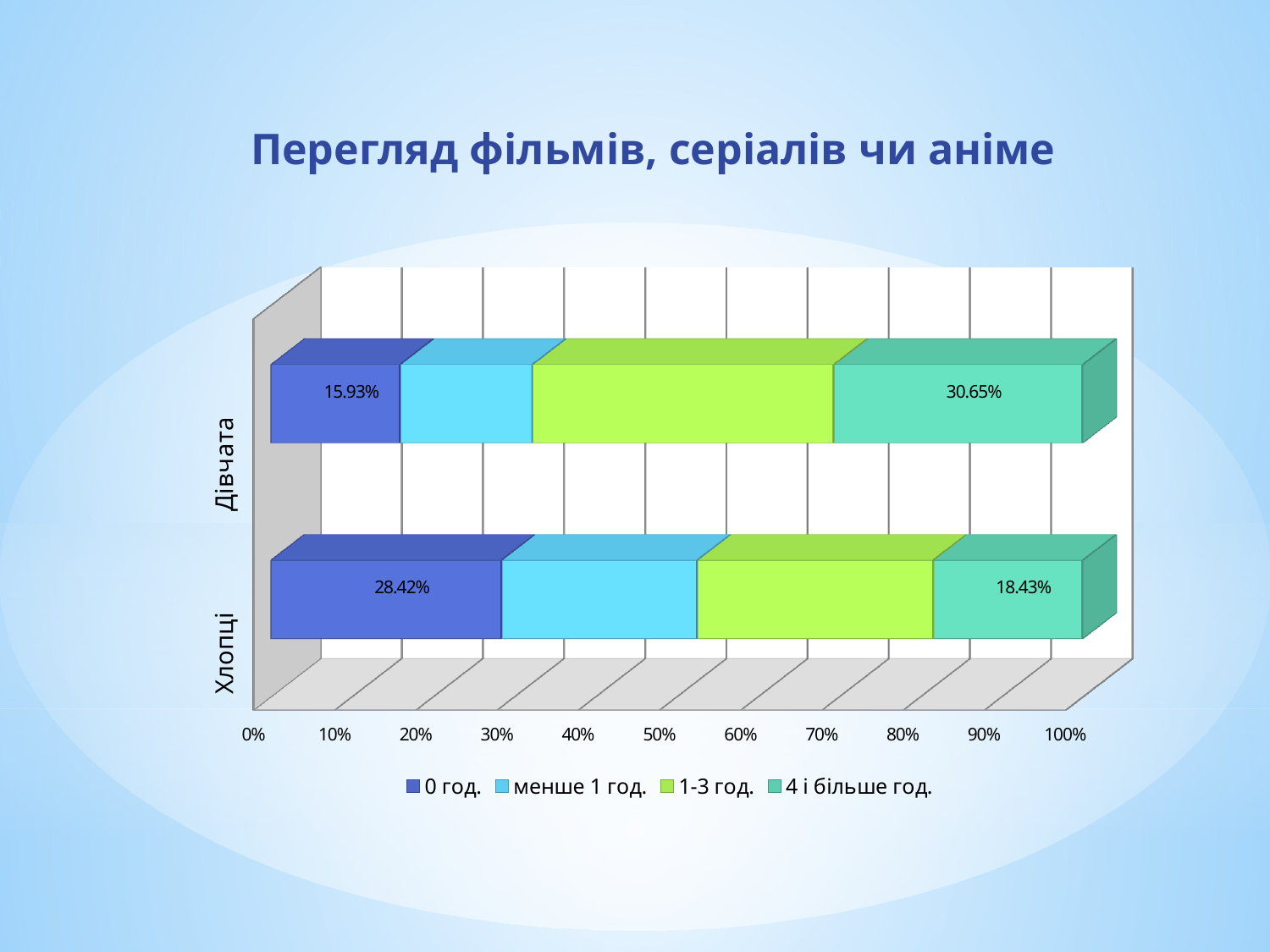
Which group has the larger value for 4 і більше год., Дівчата or Хлопці? Дівчата What is the difference between the 4 і більше год. values for Дівчата and Хлопці? 12.22% What kind of chart is shown on the slide? Stacked bar chart What is the value for 4 і більше год. for Дівчата? 30.65% What is the value for 0 год. for Дівчата? 15.93% Is the 1-3 год. segment for Дівчата greater or less than 30%? greater What is the value for 4 і більше год. for Хлопці? 18.43% How many series does the legend list? 4 What is the difference between the 0 год. values for Хлопці and Дівчата? 12.49% Which group has the larger value for 0 год., Дівчата or Хлопці? Хлопці What is the value for 0 год. for Хлопці? 28.42% How many categories are shown on the chart? 2